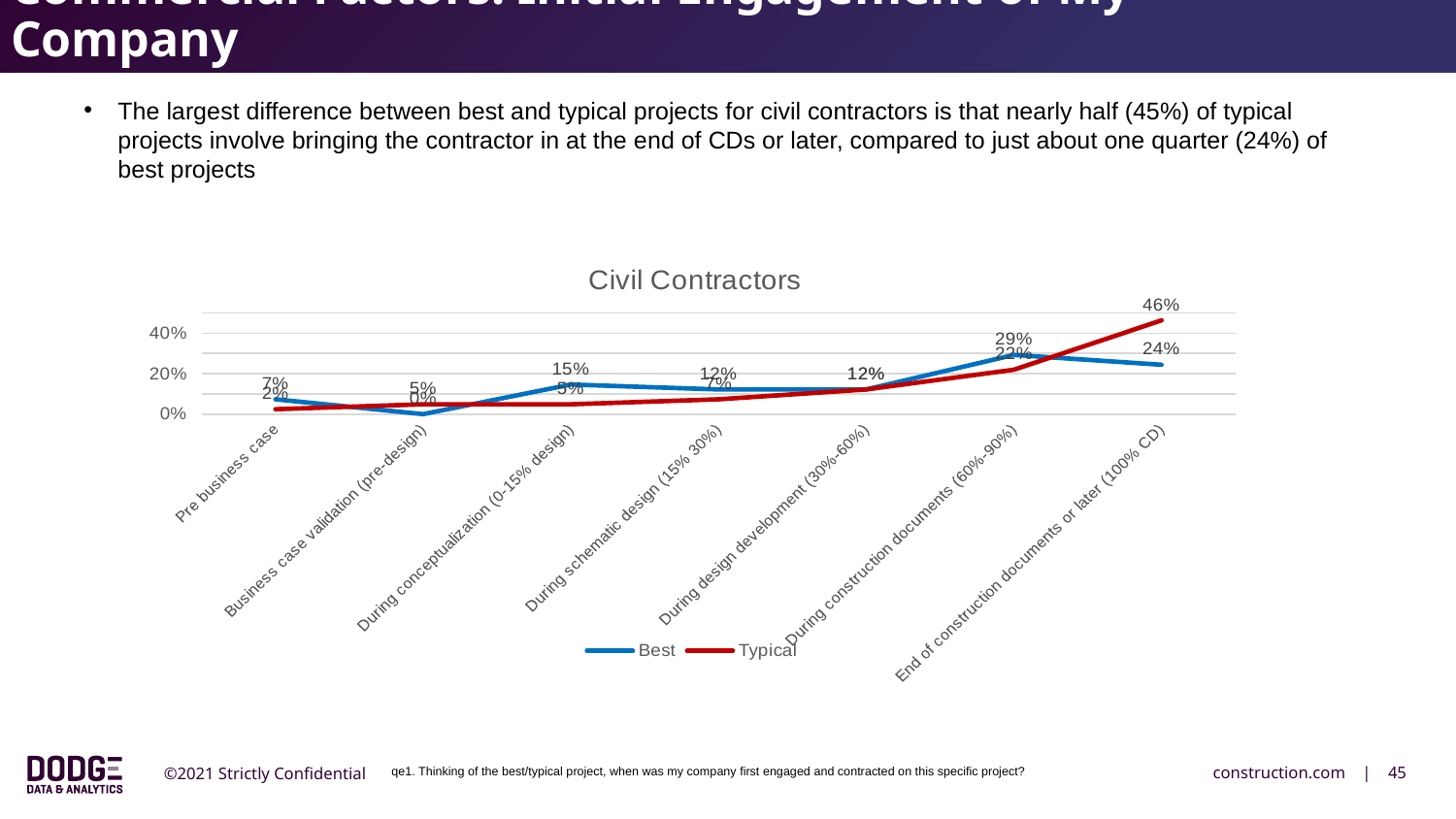
Which category has the highest Typical value? End of construction documents or later (100% CD) How many series does the chart legend list? 2 What is the difference between the Typical and Best values for 'End of construction documents or later (100% CD)'? 22% What is the Typical value for 'End of construction documents or later (100% CD)'? 46% Is the Typical value for 'End of construction documents or later (100% CD)' greater or less than 40%? greater What is the Best value for 'During construction documents (60%-90%)'? 29% What is the Best value for 'During conceptualization (0-15% design)'? 15% What type of chart is shown on the slide? Line chart Which series has the higher value at 'End of construction documents or later (100% CD)', Best or Typical? Typical What is the title of the chart? Civil Contractors What is the Best value for 'End of construction documents or later (100% CD)'? 24% How many categories are shown along the x axis of the chart? 7